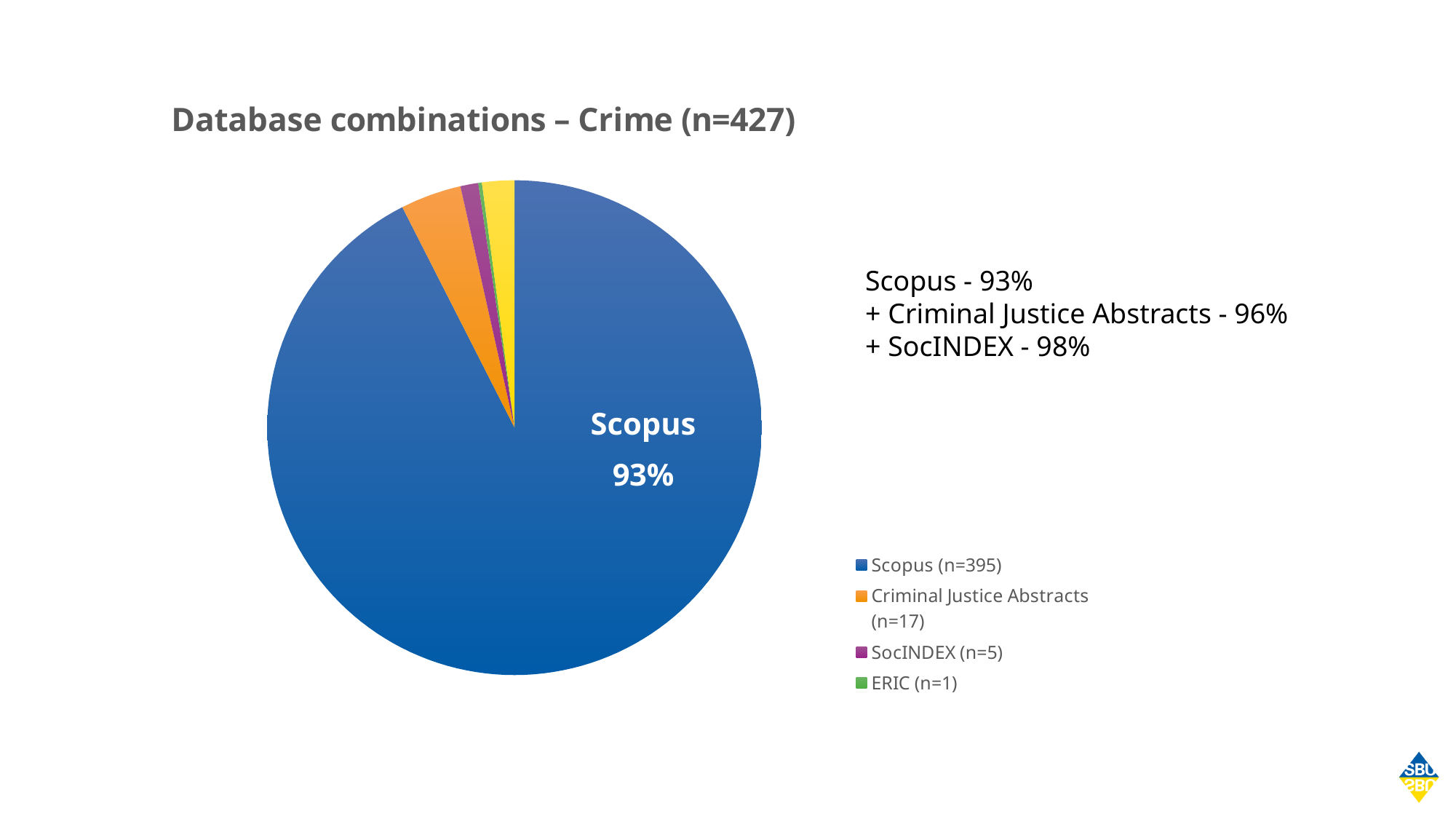
What is the n value for Criminal Justice Abstracts in the legend? 17 What is the n value for Scopus in the legend? 395 What is the n value for SocINDEX in the legend? 5 What is the difference between the n values for Scopus and Criminal Justice Abstracts? 378 Which database has the largest slice of the pie? Scopus What share of the pie does Scopus account for? 93% Which legend entry has the smallest n value? ERIC (n=1) How many entries does the chart legend list? 4 What is the title of the chart? Database combinations – Crime (n=427) What kind of chart is shown on the slide? pie chart Which has a larger slice, Criminal Justice Abstracts or SocINDEX? Criminal Justice Abstracts What colour is the Scopus slice? blue